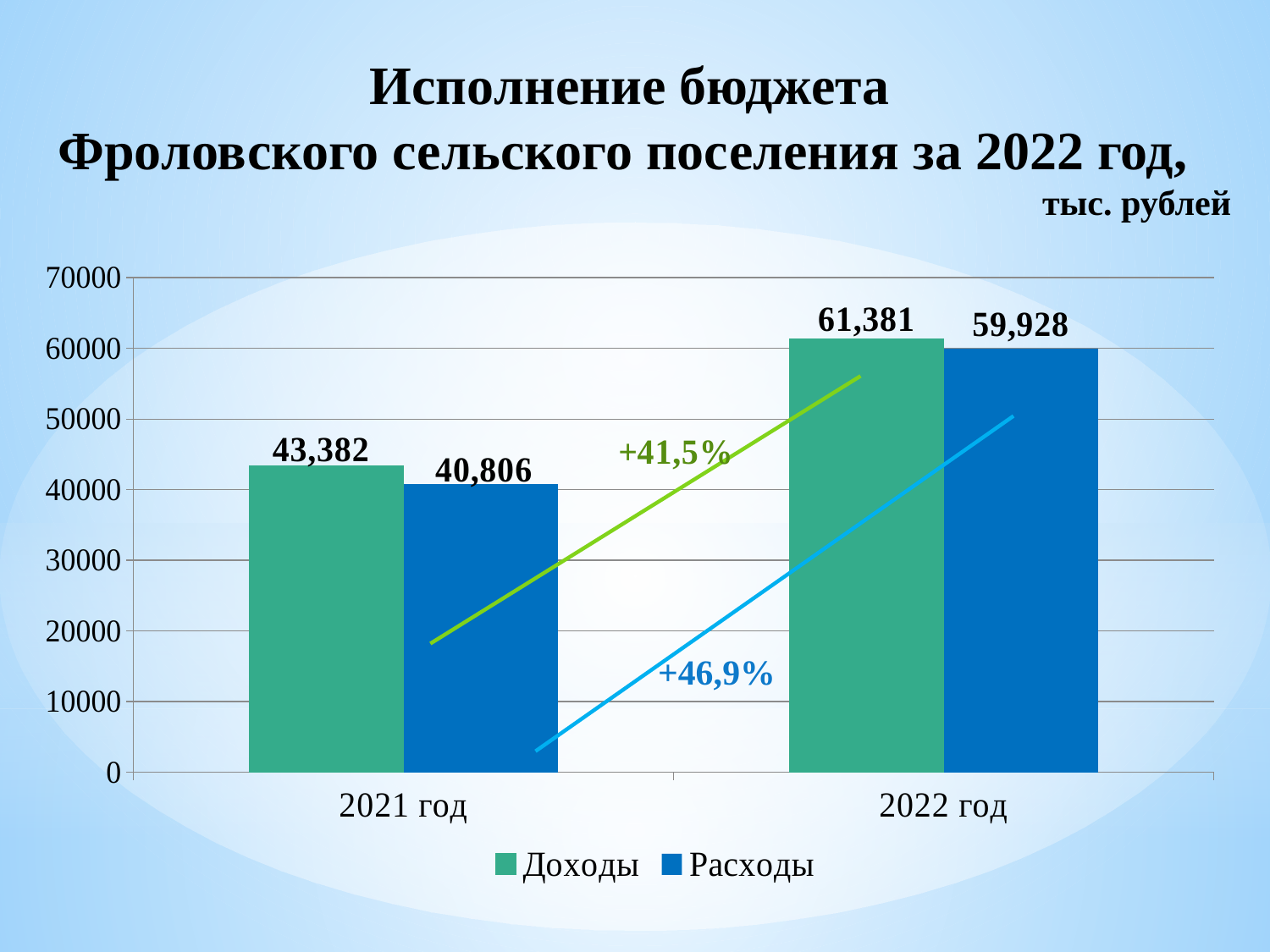
Which bar has the highest value on the chart? Доходы, 2022 год Which is larger in 2022 год, Доходы or Расходы? Доходы How many categories are shown on the x axis? 2 Which bar has the lowest value on the chart? Расходы, 2021 год How many series does the legend list? 2 What is the difference between Доходы and Расходы in 2021 год? 2,576 What is the value of Расходы for 2021 год? 40,806 What is the value of Доходы for 2021 год? 43,382 What percentage growth is shown for Расходы from 2021 год to 2022 год? +46,9% What is the value of Расходы for 2022 год? 59,928 What is the difference between Доходы in 2022 год and Доходы in 2021 год? 17,999 What kind of chart is shown on the slide? Bar chart